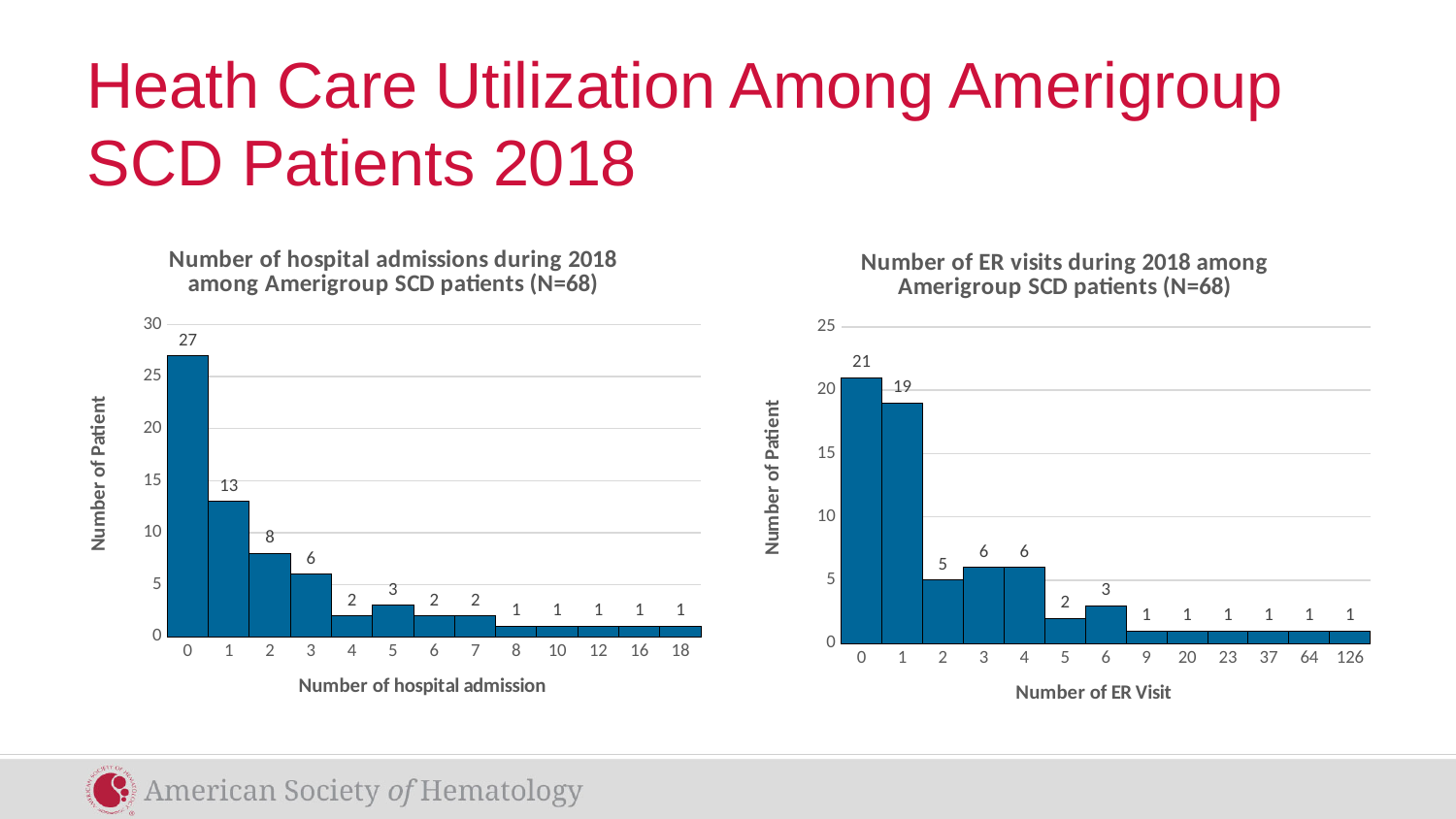
In the right chart (ER visits), what is the largest number of ER visits shown on the x axis? 126 In the right chart (ER visits), what is the difference between the number of patients with 0 ER visits and with 1 ER visit? 2 In the left chart (hospital admissions), how many categories are shown on the x axis? 13 In the right chart (ER visits), which is larger: the number of patients with 2 ER visits or with 3 ER visits? 3 ER visits In the left chart (hospital admissions), what kind of chart is used? Bar chart In the left chart (hospital admissions), what is the difference between the number of patients with 0 admissions and the number with 1 admission? 14 In the left chart (hospital admissions), how many patients had 0 hospital admissions? 27 In the right chart (ER visits), how many patients had 6 ER visits? 3 In the left chart (hospital admissions), which number of hospital admissions has the highest number of patients? 0 In the right chart (ER visits), how many patients had 1 ER visit? 19 In the left chart (hospital admissions), how many patients had 2 hospital admissions? 8 In the right chart (ER visits), do the number of patients generally rise or fall as the number of ER visits increases? Fall